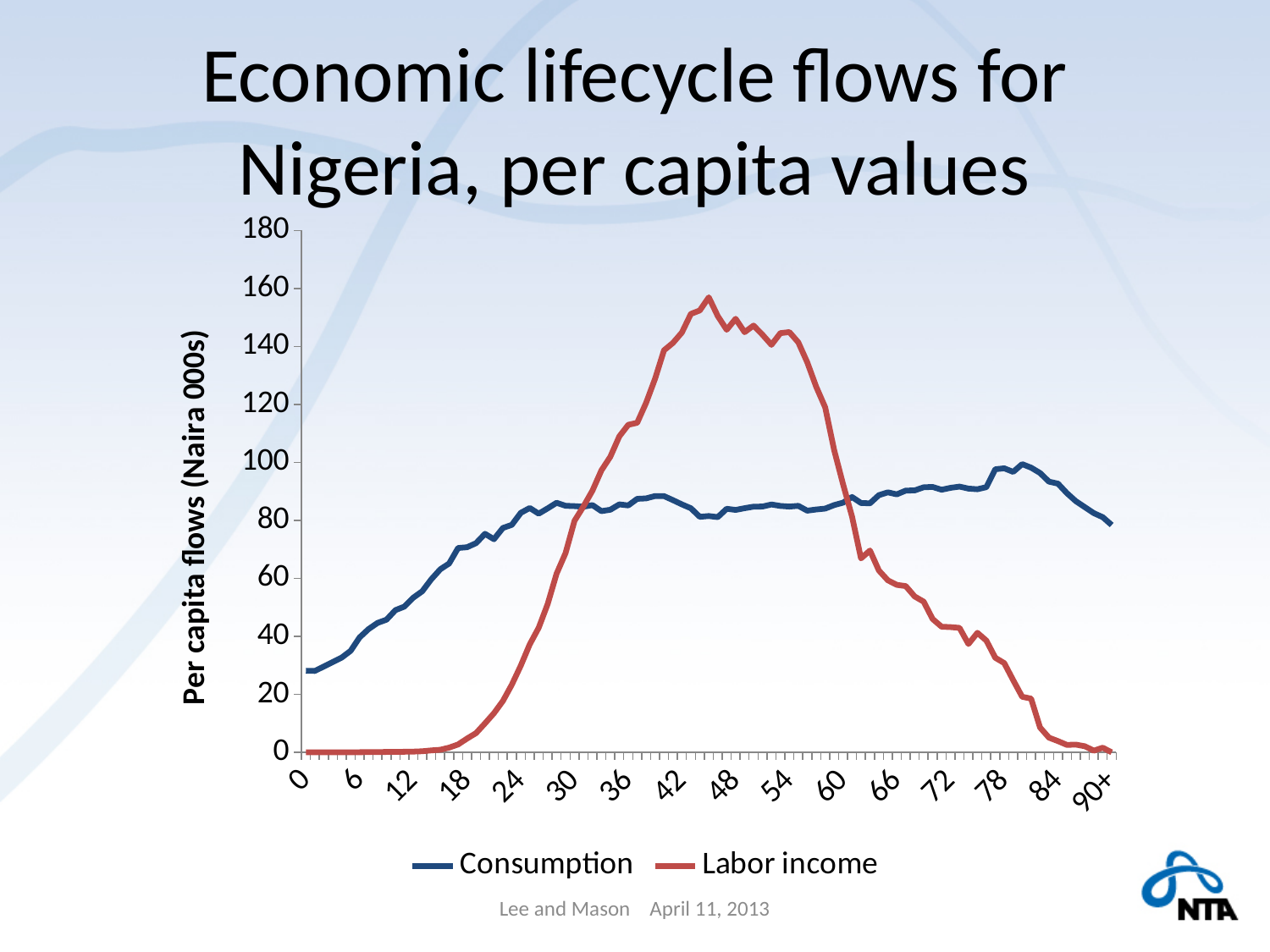
Is the Consumption value at age 0 greater or less than 20? greater Is the Labor income value at age 0 greater or less than 20? less Does the Labor income line rise or fall between age 48 and age 84? fall What is the label of the vertical axis? Per capita flows (Naira 000s) Is the Labor income value at age 72 greater or less than 60? less At age 45, which series has the larger value, Consumption or Labor income? Labor income What are the two series named in the legend? Consumption and Labor income How many series does the legend list? 2 At age 12, which series has the larger value, Consumption or Labor income? Consumption What kind of chart is shown on the slide? line chart